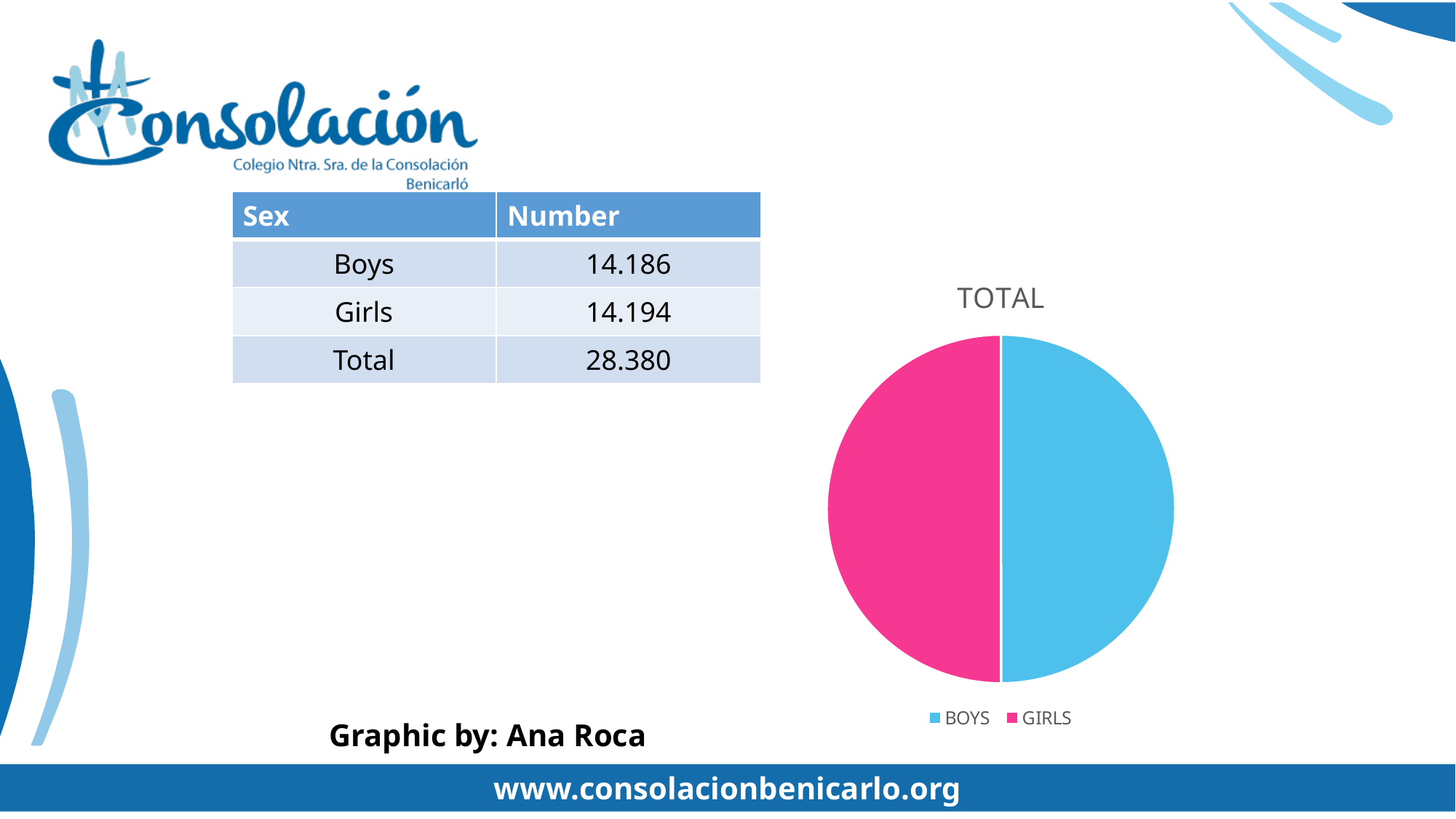
How many entries does the pie chart's legend list? 2 What kind of chart is shown on the slide? pie chart What is the total number of boys and girls shown on the slide? 28.380 How many slices does the pie chart have? 2 According to the slide, what is the number for Boys? 14.186 What are the two categories shown in the pie chart's legend? BOYS and GIRLS What is the title of the pie chart? TOTAL According to the slide, what is the number for Girls? 14.194 Which colour represents GIRLS in the pie chart? pink